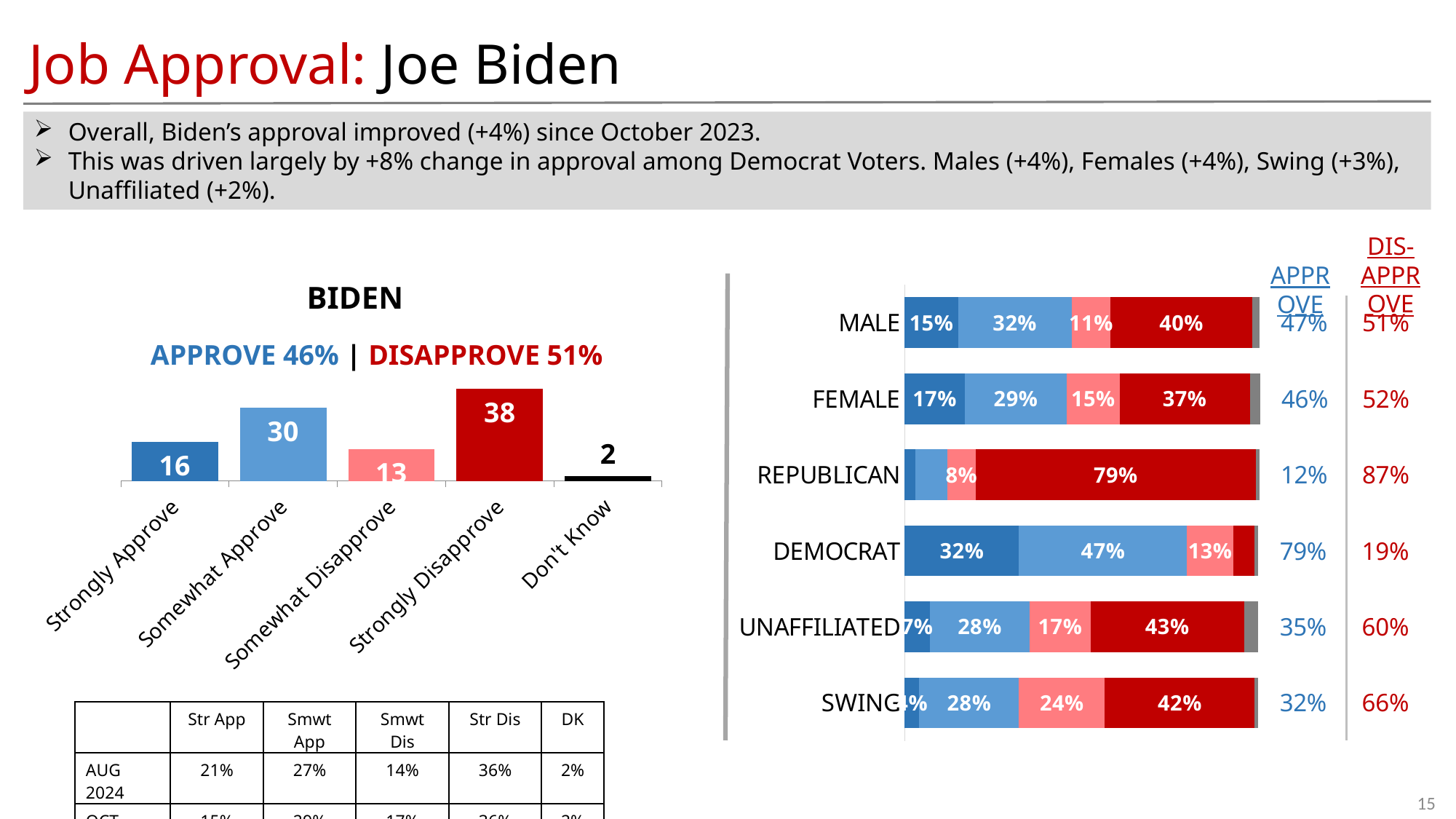
In the BIDEN bar chart on the left, which category has the lowest value? Don't Know In the stacked bar chart on the right, what is the Strongly Disapprove (dark red) value for REPUBLICAN? 79% In the BIDEN bar chart on the left, what is the value for Strongly Approve? 16 In the stacked bar chart on the right, what is the difference between the Somewhat Approve (light blue) value for DEMOCRAT and for MALE? 15% In the BIDEN bar chart on the left, what is the difference between Strongly Disapprove and Somewhat Approve? 8 What kind of chart is the BIDEN chart on the left? Bar chart How many demographic groups are shown in the stacked bar chart on the right? 6 In the stacked bar chart on the right, what is the Strongly Disapprove (dark red) value for MALE? 40% In the stacked bar chart on the right, what is the Somewhat Approve (light blue) value for DEMOCRAT? 47% In the stacked bar chart on the right, which is larger: the Somewhat Approve (light blue) value for MALE or for FEMALE? MALE How many categories are shown in the BIDEN bar chart on the left? 5 In the BIDEN bar chart on the left, which category has the highest value? Strongly Disapprove